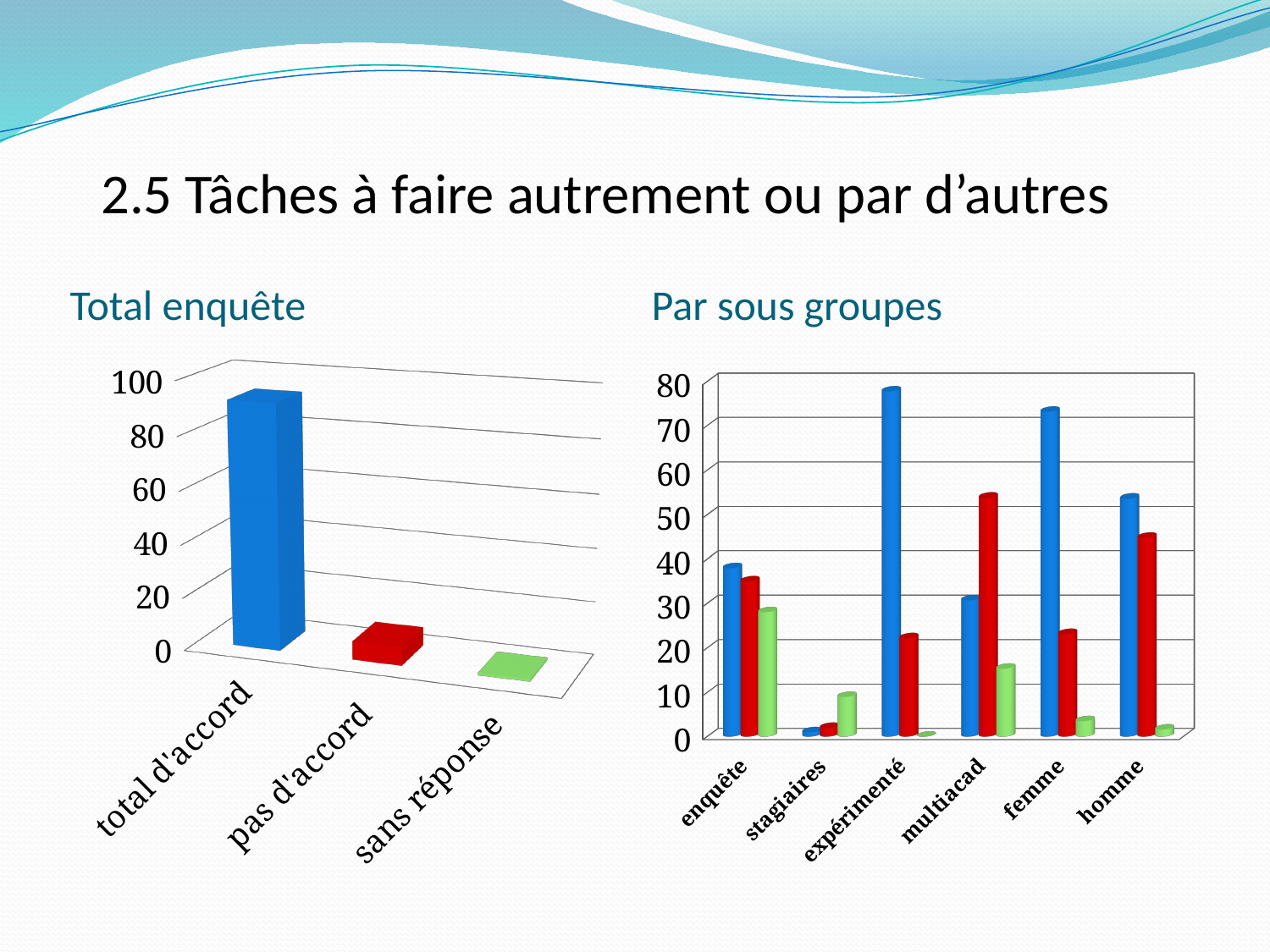
In the 'Par sous groupes' chart, which category has the tallest blue bar? expérimenté In the 'Total enquête' chart, is the value for 'pas d'accord' greater or less than 20? less In the 'Par sous groupes' chart, is the blue bar for 'expérimenté' greater or less than 70? greater In the 'Par sous groupes' chart, which category has the shortest blue bar? stagiaires In the 'Total enquête' chart, which category has the highest value? total d'accord In the 'Total enquête' chart, is the value for 'total d'accord' greater or less than 80? greater How many categories are shown on the x axis of the 'Par sous groupes' chart? 6 In the 'Par sous groupes' chart, for 'multiacad', which is larger: the blue bar or the red bar? the red bar In the 'Total enquête' chart, which category has the lowest value? sans réponse How many categories are shown on the x axis of the 'Total enquête' chart? 3 What kind of chart is the 'Total enquête' chart on the left? bar chart In the 'Par sous groupes' chart, how many bars are plotted for each category? 3